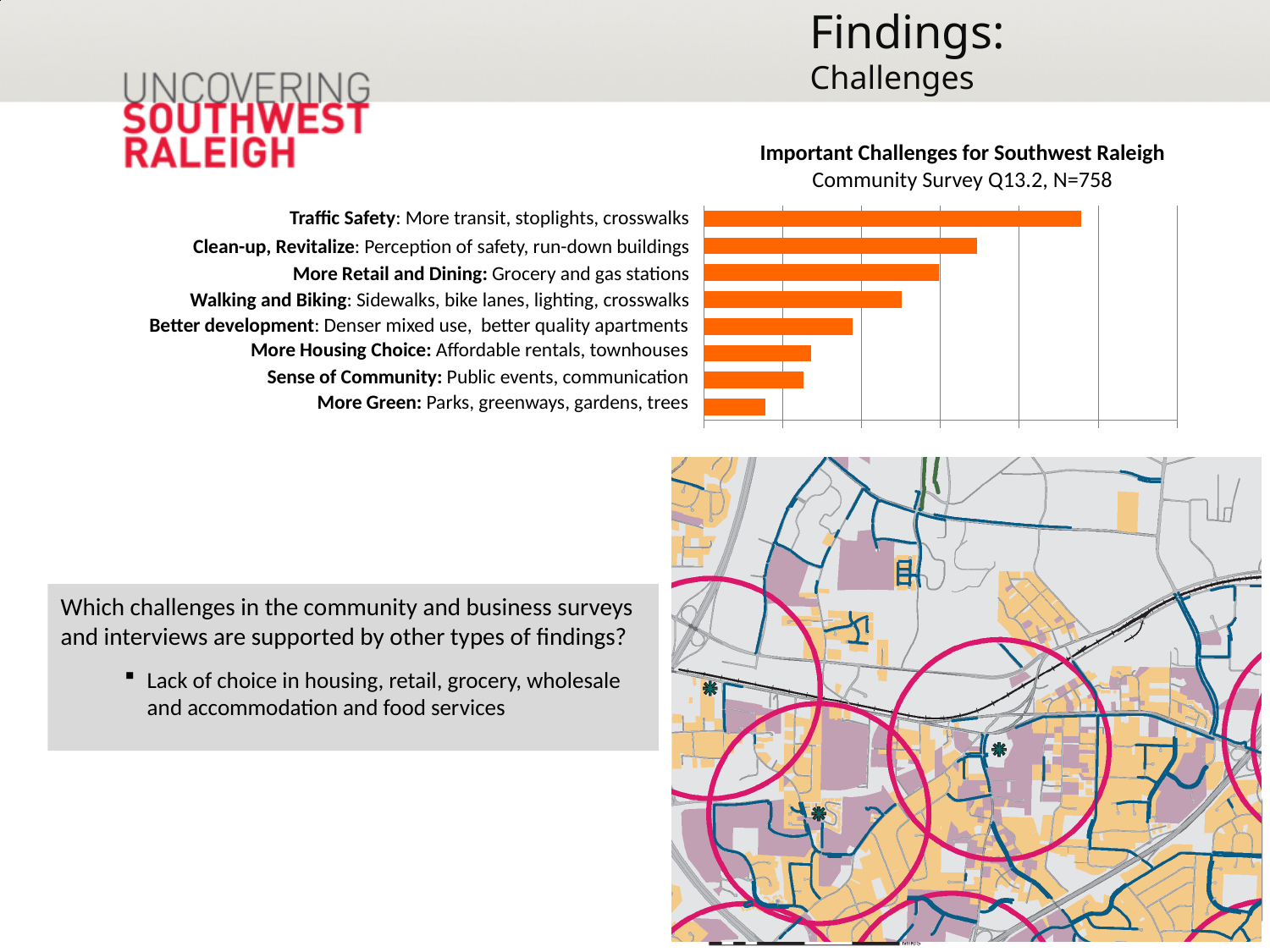
Do the bar lengths in the 'Important Challenges for Southwest Raleigh' chart increase or decrease from the top category to the bottom category? decrease What kind of chart is shown under the title 'Important Challenges for Southwest Raleigh'? bar chart How many challenge categories are plotted in the 'Important Challenges for Southwest Raleigh' chart? 8 In the 'Important Challenges for Southwest Raleigh' chart, which bar is longer: Walking and Biking or Better development? Walking and Biking Which challenge is ranked second in the 'Important Challenges for Southwest Raleigh' chart? Clean-up, Revitalize In the 'Important Challenges for Southwest Raleigh' chart, which bar is longer: Clean-up, Revitalize or More Retail and Dining? Clean-up, Revitalize Which challenge has the longest bar in the 'Important Challenges for Southwest Raleigh' chart? Traffic Safety In the 'Important Challenges for Southwest Raleigh' chart, which bar is longer: Traffic Safety or More Green? Traffic Safety What is the sample size (N) stated in the subtitle of the 'Important Challenges for Southwest Raleigh' chart? N=758 Which challenge has the shortest bar in the 'Important Challenges for Southwest Raleigh' chart? More Green